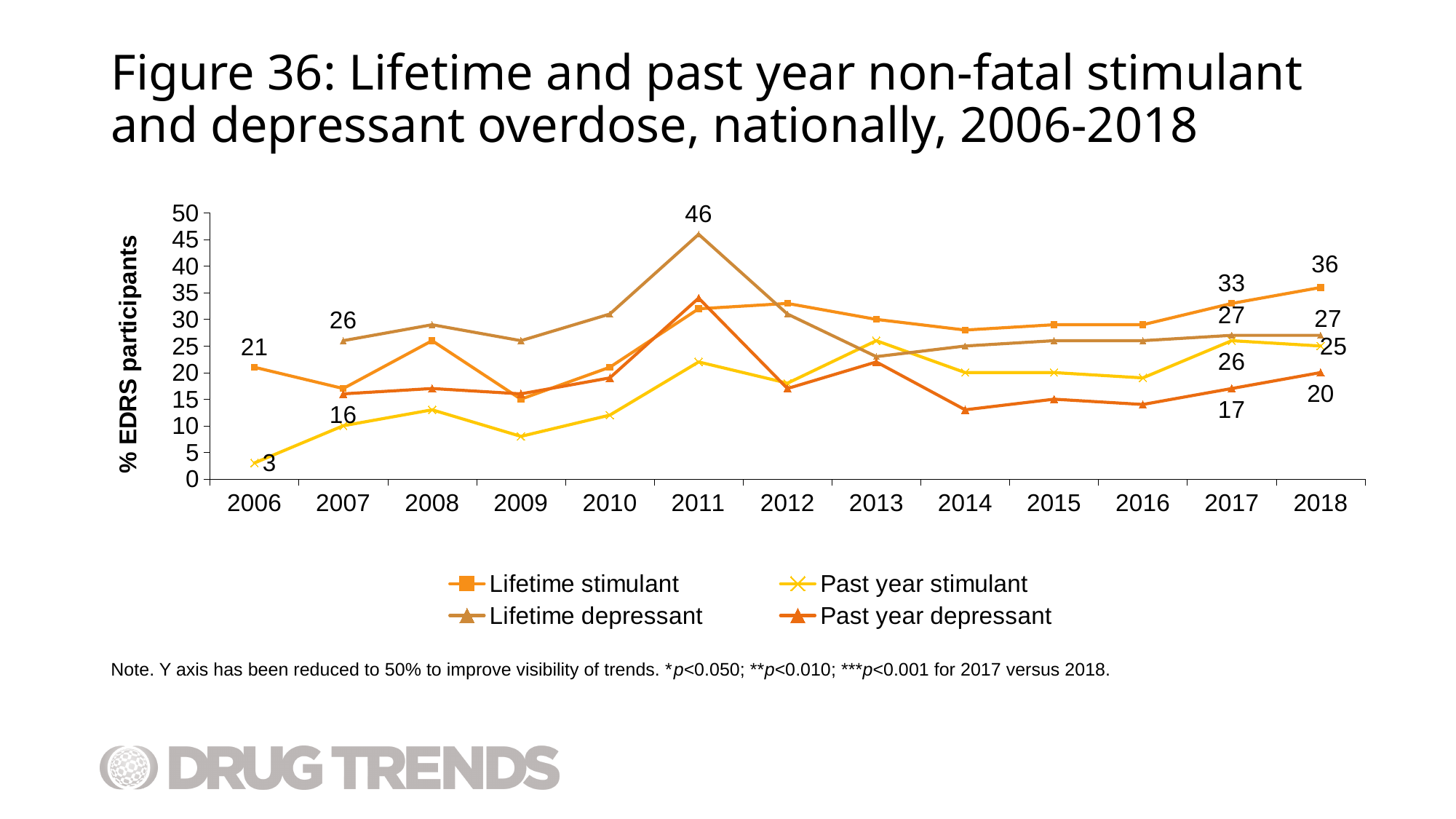
What is the value for Lifetime stimulant in 2018? 36 What is the value for Lifetime depressant in 2011? 46 In 2018, which is larger: Past year stimulant or Past year depressant? Past year stimulant What is the value for Past year stimulant in 2006? 3 What kind of chart is shown on the slide? line chart Is the value for Past year stimulant in 2009 greater or less than 10? less Which series has the highest value in 2018? Lifetime stimulant How many series does the legend list? 4 What is the value for Past year depressant in 2007? 16 What is the label on the y axis? % EDRS participants How many years are shown on the x axis? 13 By how much did Lifetime stimulant increase from 2017 to 2018? 3